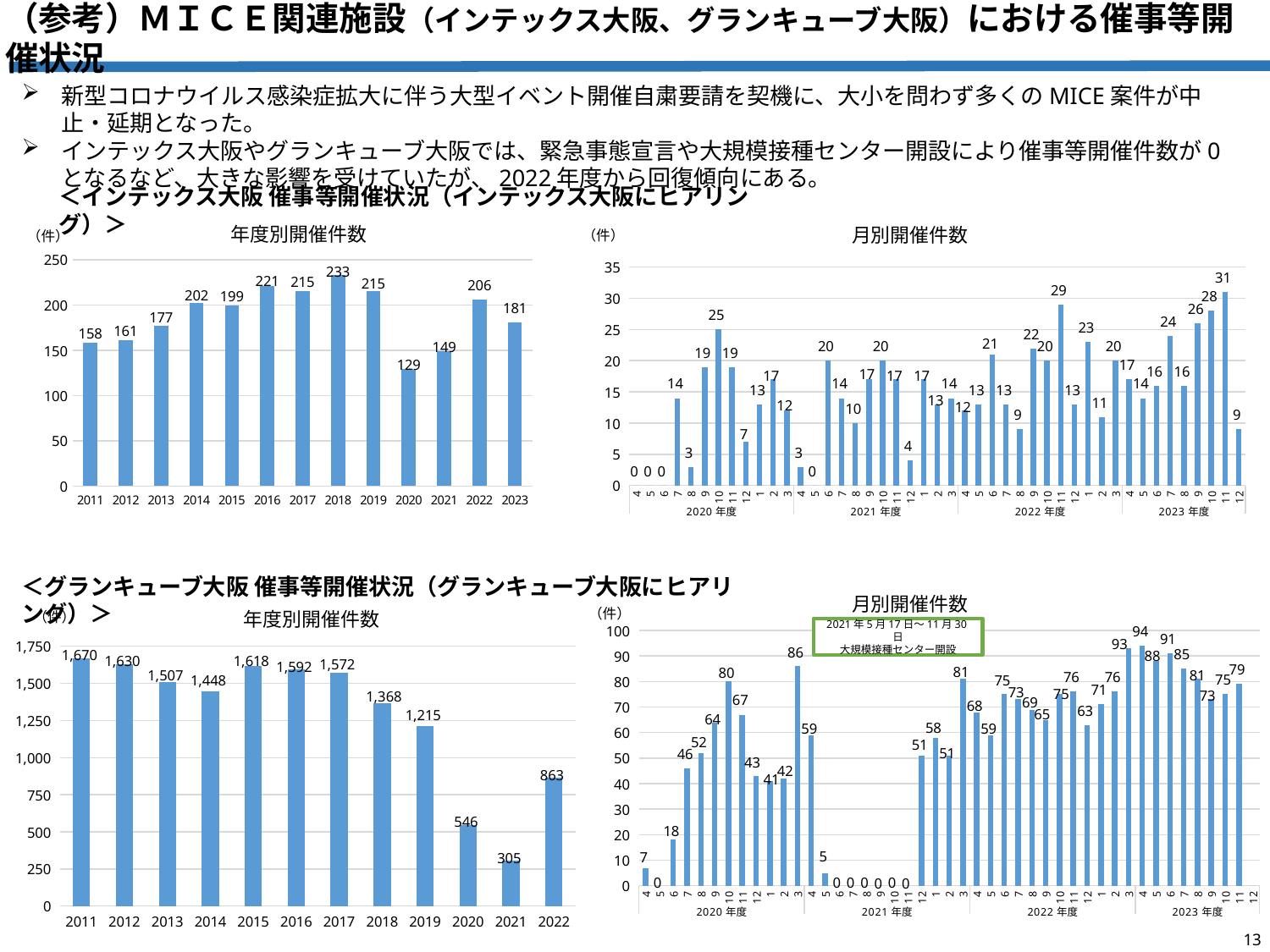
In the top-left chart (インテックス大阪 年度別開催件数), which year has the lowest value? 2020 In the bottom-left chart (グランキューブ大阪 年度別開催件数), which year has the lowest value? 2021 In the top-left chart (インテックス大阪 年度別開催件数), how many years are shown on the x axis? 13 In the bottom-left chart (グランキューブ大阪 年度別開催件数), which is larger, the value for 2020 or the value for 2022? 2022 In the bottom-left chart (グランキューブ大阪 年度別開催件数), what is the difference between the values for 2019 and 2020? 669 What is the title of the top-right chart? 月別開催件数 In the top-left chart (インテックス大阪 年度別開催件数), what is the value for 2018? 233 What kind of chart is the bottom-left chart (グランキューブ大阪 年度別開催件数)? bar chart In the top-left chart (インテックス大阪 年度別開催件数), what is the difference between the values for 2022 and 2023? 25 In the bottom-left chart (グランキューブ大阪 年度別開催件数), what is the value for 2011? 1,670 In the bottom-right chart (グランキューブ大阪 月別開催件数), what is the highest value shown? 94 In the top-right chart (インテックス大阪 月別開催件数), what is the highest value shown? 31